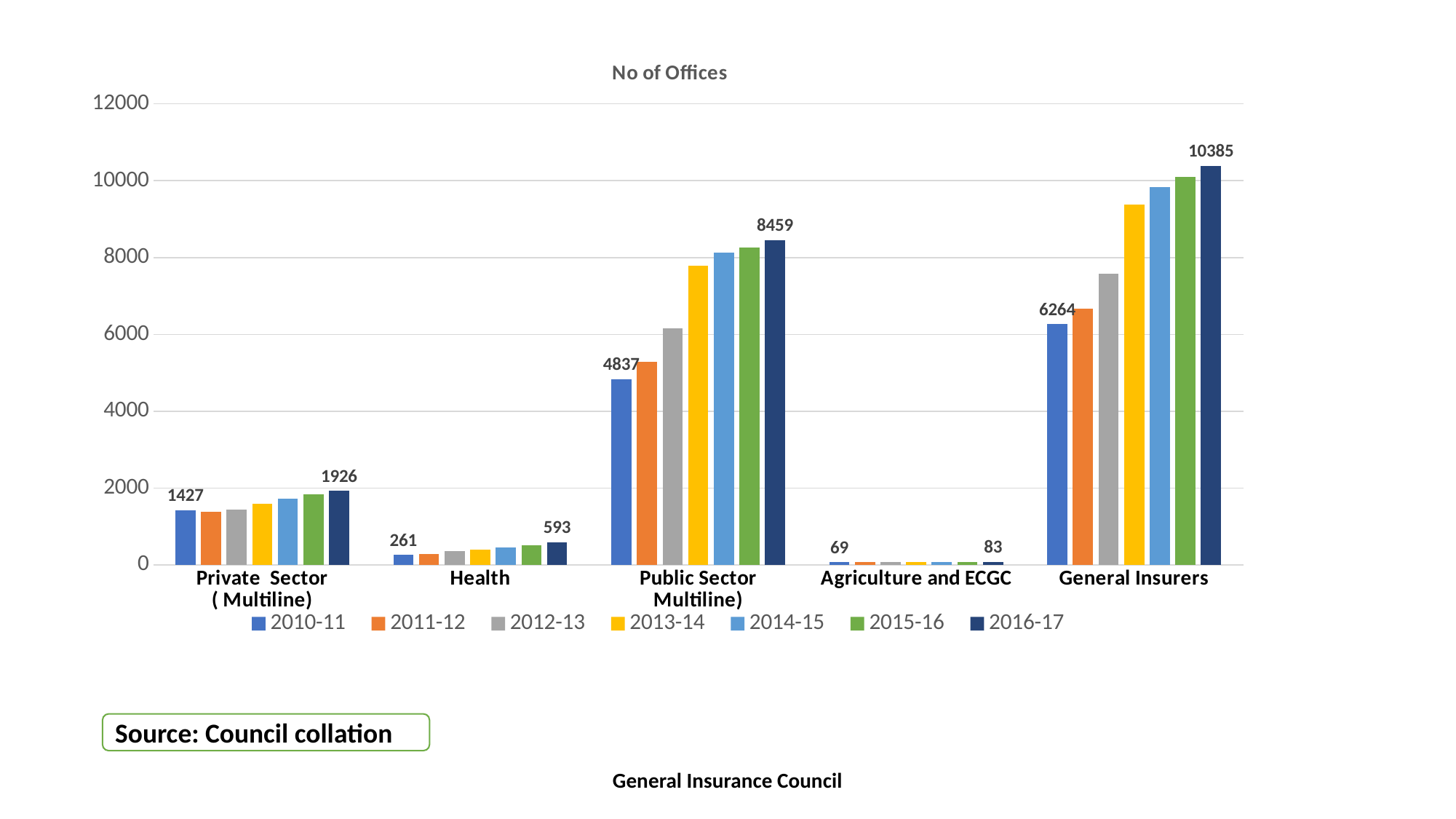
What is the number of offices for Agriculture and ECGC in 2010-11? 69 Is the 2013-14 value for General Insurers greater or less than 8000? greater What is the difference between the 2016-17 and 2010-11 values for Private Sector (Multiline)? 499 Which category has the lowest number of offices in 2010-11? Agriculture and ECGC What is the number of offices for General Insurers in 2016-17? 10385 What is the number of offices for Public Sector (Multiline) in 2010-11? 4837 How many series does the legend list? 7 Do the values for Public Sector (Multiline) rise or fall from 2010-11 to 2016-17? rise What kind of chart is shown on the slide? bar chart Which is larger: the 2016-17 value for Public Sector (Multiline) or the 2016-17 value for General Insurers? General Insurers What is the number of offices for Health in 2016-17? 593 Which category has the highest number of offices in 2016-17? General Insurers